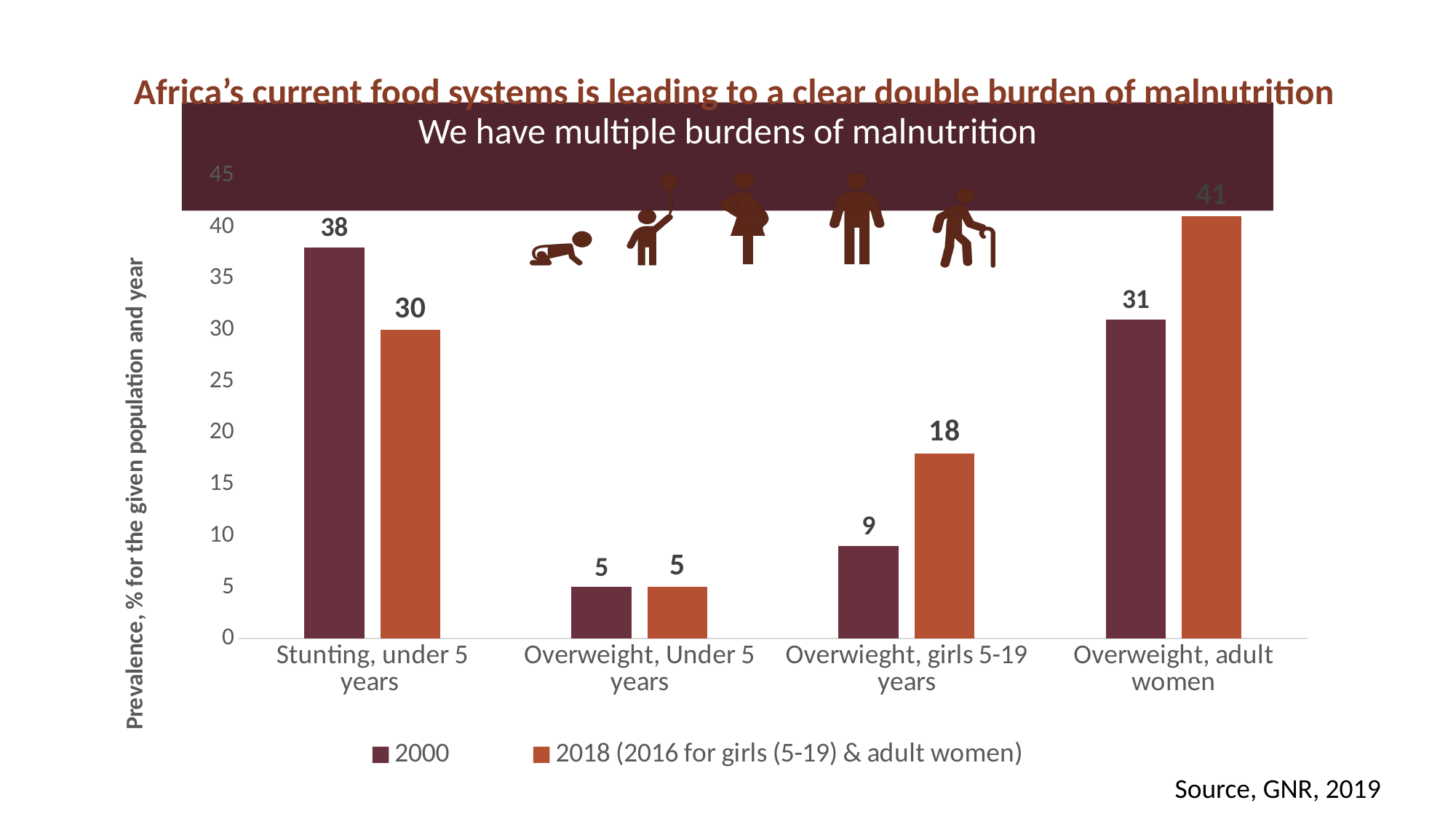
What is the value for Overweight, adult women in the 2018 (2016 for girls (5-19) & adult women) series? 41 Which category has the lowest value in the 2018 (2016 for girls (5-19) & adult women) series? Overweight, Under 5 years How many series does the legend list? 2 Which is larger for Overweight, adult women: the 2000 value or the 2018 value? 2018 What kind of chart is shown on the slide? Bar chart What is the value for Overweight, Under 5 years in the 2018 series? 5 What is the difference between the 2018 and 2000 values for Overweight, girls 5-19 years? 9 How many categories are shown on the x axis? 4 What is the value for Overweight, girls 5-19 years in the 2000 series? 9 What is the difference between the 2000 and 2018 values for Stunting, under 5 years? 8 What is the value for Stunting, under 5 years in the 2000 series? 38 Which category has the highest value in the 2000 series? Stunting, under 5 years